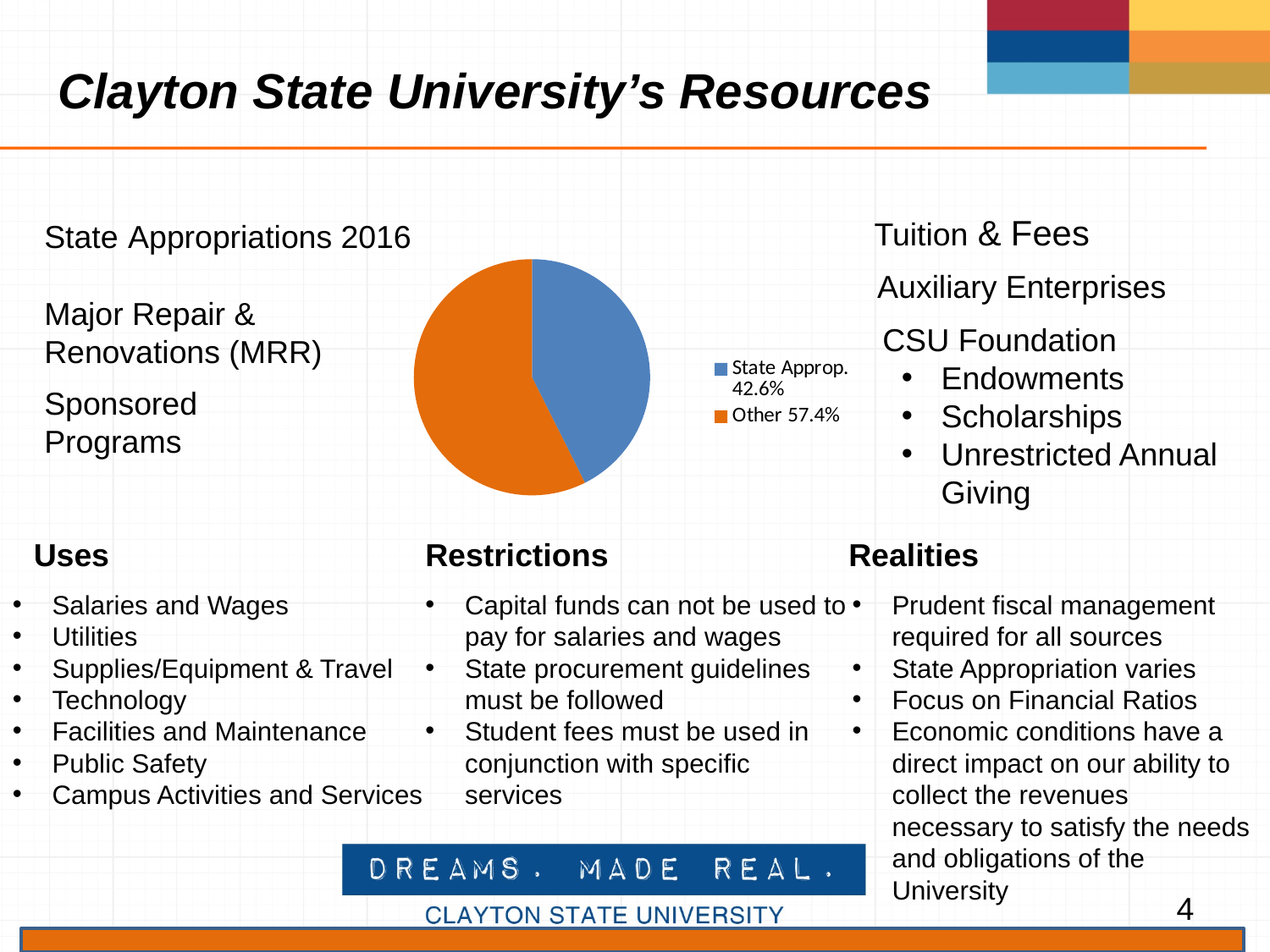
Which is larger in the pie chart, State Approp. or Other? Other Is the share for State Approp. greater or less than 50%? less What share of the pie does State Approp. represent? 42.6% Which slice of the pie chart is the largest? Other By how many percentage points does the Other slice exceed the State Approp. slice? 14.8 percentage points What colour is the Other slice in the pie chart? orange Which slice of the pie chart is the smallest? State Approp. What colour is the State Approp. slice in the pie chart? blue What share of the pie does Other represent? 57.4% What kind of chart is shown on the slide? pie chart How many slices does the pie chart have? 2 How many entries does the pie chart's legend list? 2